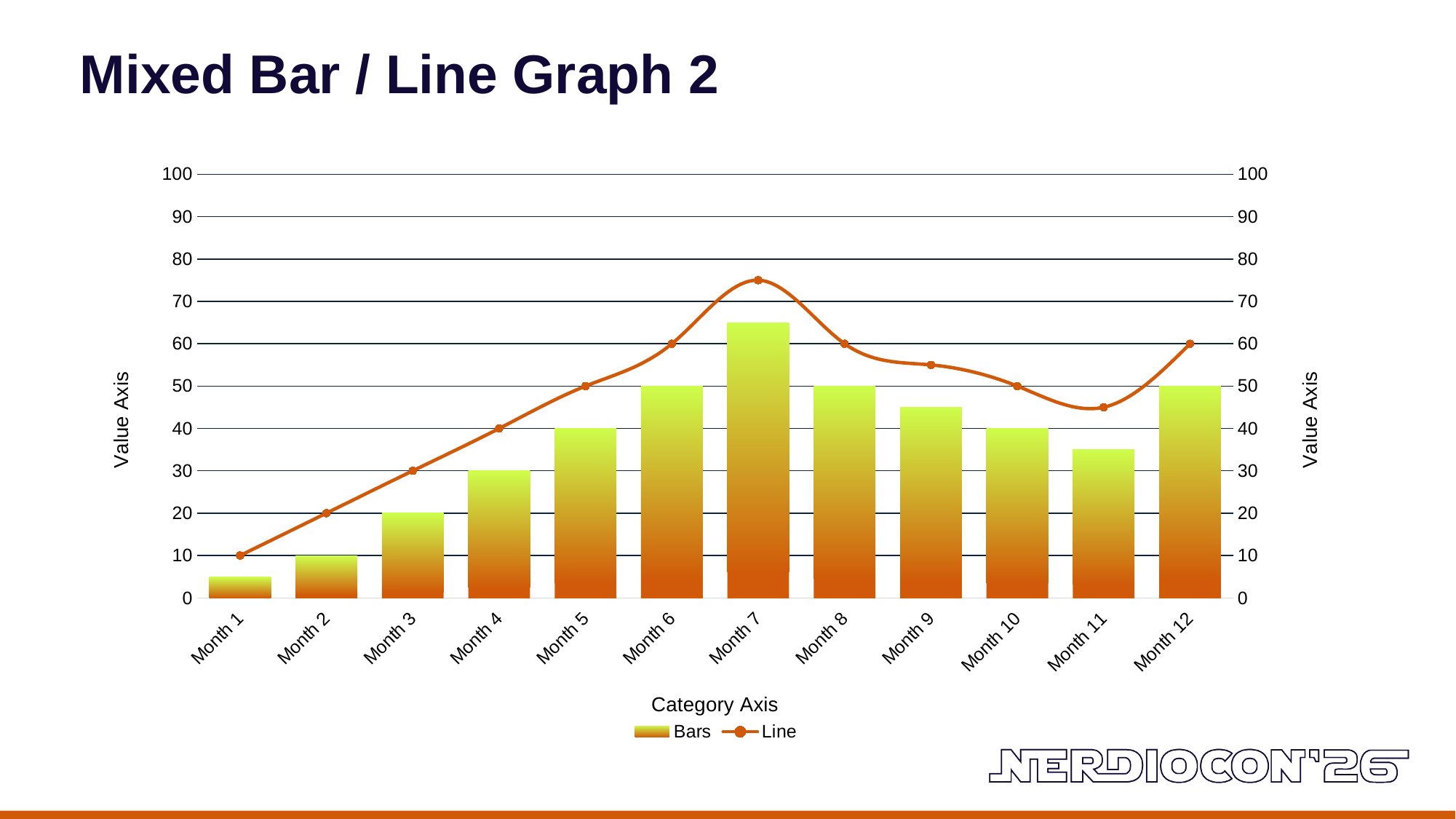
What type of chart is shown on the slide? A combined bar and line chart How many series does the legend list? 2 What is the value of the Line series for Month 6? 60 What is the value of the Bars series for Month 12? 50 Does the Line series rise or fall from Month 1 to Month 7? rise Which month has the lowest value in the Line series? Month 1 Is the Bars value for Month 11 greater or less than 40? less How many categories are shown on the category axis? 12 Is the Line value for Month 7 greater or less than 70? greater What is the value of the Bars series for Month 4? 30 Which month has the highest value in the Bars series? Month 7 What is the difference between the Bars values for Month 6 and Month 3? 30